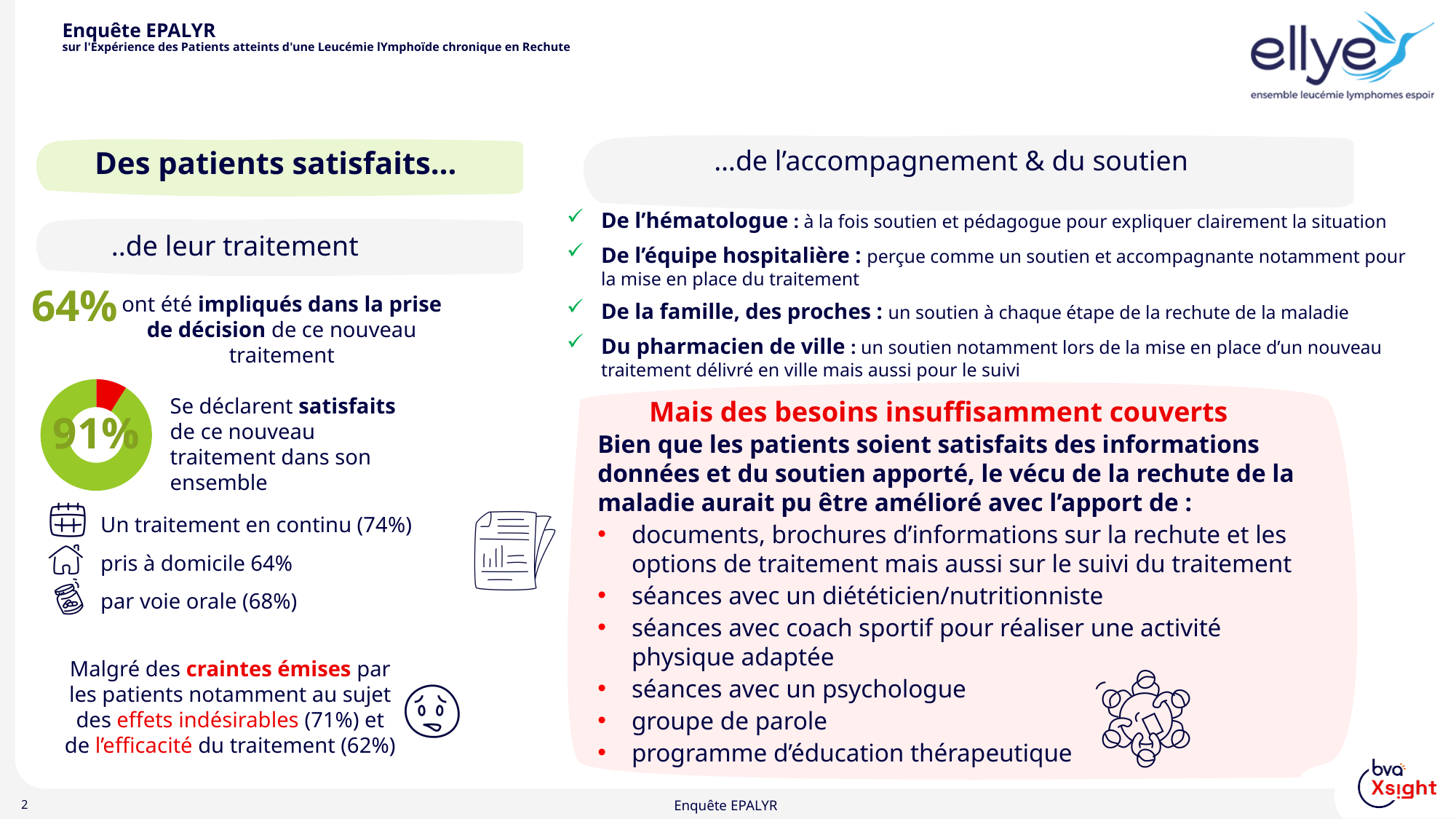
How many slices does the doughnut chart have? 2 What colour is the largest slice of the doughnut chart? green Which slice of the doughnut chart is larger, the green one or the red one? the green one Is the share of the red slice in the doughnut chart greater or less than 25%? less What percentage is printed in the centre of the doughnut chart? 91% What kind of chart is shown next to the text 'Se déclarent satisfaits de ce nouveau traitement dans son ensemble'? pie chart (doughnut) What share of the doughnut chart does the green slice represent? 91% What does the 91% in the doughnut chart represent, according to the text beside it? patients who declare themselves satisfied with the new treatment overall (Se déclarent satisfaits de ce nouveau traitement dans son ensemble) Is the share of the green slice in the doughnut chart greater or less than 50%? greater